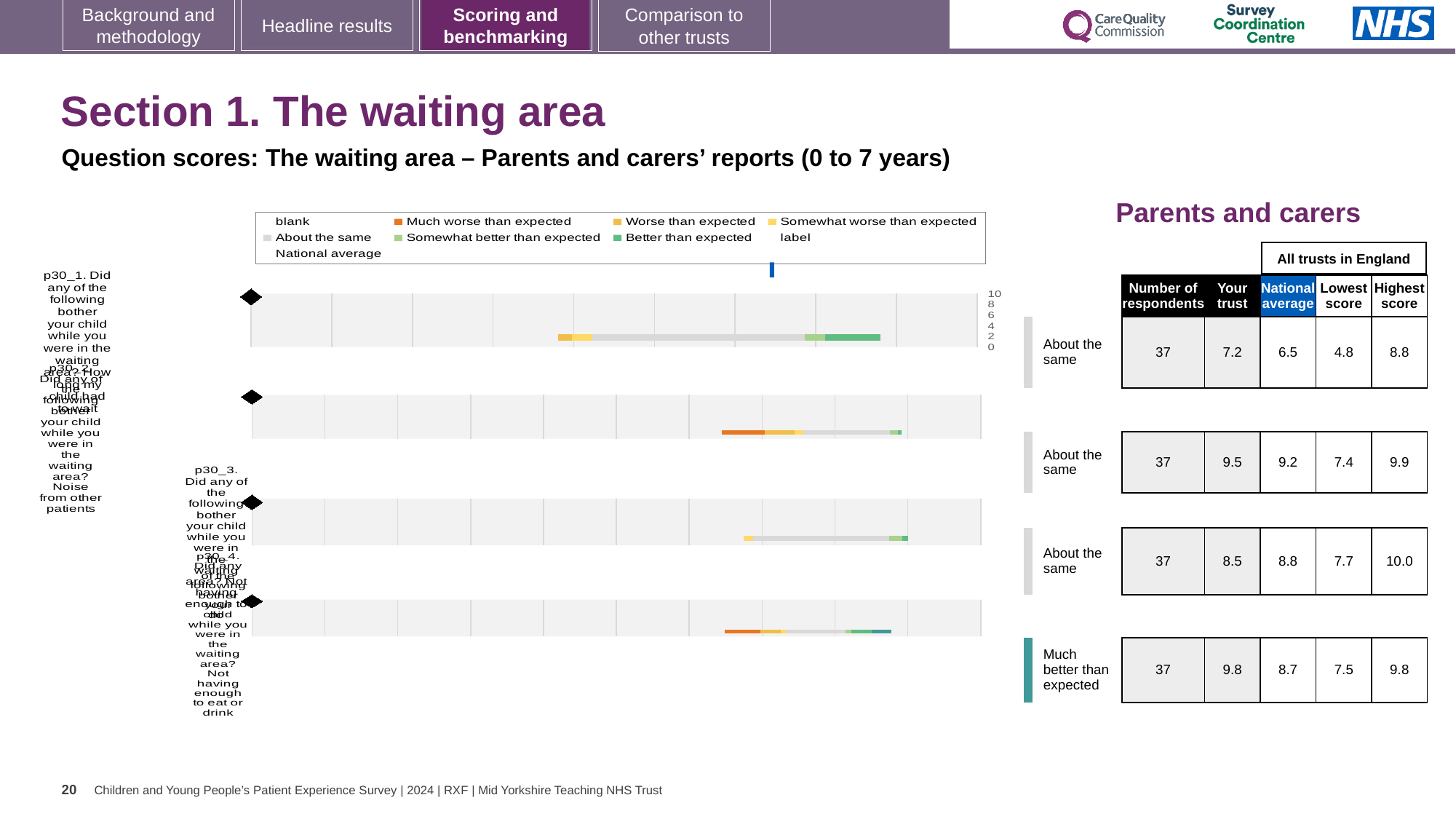
Which legend entry is shown in orange? Much worse than expected What is the subtitle describing the chart's question scores? Question scores: The waiting area – Parents and carers’ reports (0 to 7 years) In the table beside the chart, which row has the highest 'Your trust' score? the fourth row (p30_4), 9.8 In the table beside the chart, what is the difference between the highest score and the lowest score for the second row (p30_2)? 2.5 What benchmark category is given for the fourth row (p30_4)? Much better than expected How many question rows (bars) does the chart show? 4 In the table beside the chart, what is the national average for the fourth row (p30_4)? 8.7 In the table beside the chart, what is the lowest score for the first row (p30_1)? 4.8 What kind of chart is shown on the slide? bar chart In the table beside the chart, what is the 'Your trust' score for the first row (p30_1)? 7.2 In the table beside the chart, what is the number of respondents for the first row (p30_1)? 37 In the table beside the chart, for the third row (p30_3), which is larger: the 'Your trust' score or the national average? National average